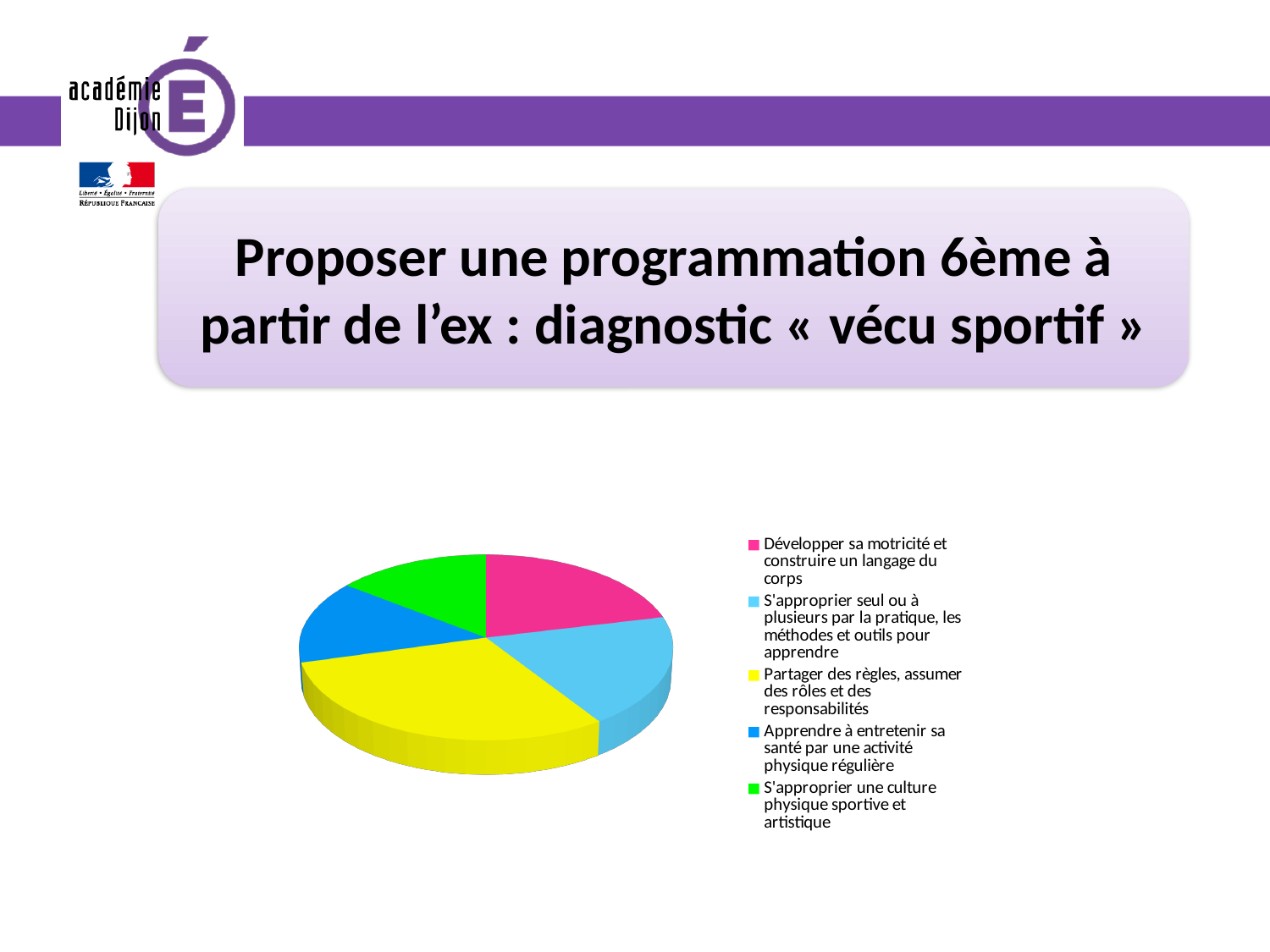
Which slice is larger: "S'approprier seul ou à plusieurs par la pratique, les méthodes et outils pour apprendre" or "S'approprier une culture physique sportive et artistique"? S'approprier seul ou à plusieurs par la pratique, les méthodes et outils pour apprendre Which category has the largest slice of the pie chart? Partager des règles, assumer des rôles et des responsabilités What kind of chart is shown on the slide? Pie chart Which category is shown in yellow in the pie chart? Partager des règles, assumer des rôles et des responsabilités How many entries does the legend of the pie chart list? 5 Which slice is larger: "Partager des règles, assumer des rôles et des responsabilités" or "S'approprier une culture physique sportive et artistique"? Partager des règles, assumer des rôles et des responsabilités Which slice is larger: "Développer sa motricité et construire un langage du corps" or "Apprendre à entretenir sa santé par une activité physique régulière"? Développer sa motricité et construire un langage du corps How many slices does the pie chart have? 5 What colour is the slice for "Développer sa motricité et construire un langage du corps"? Pink